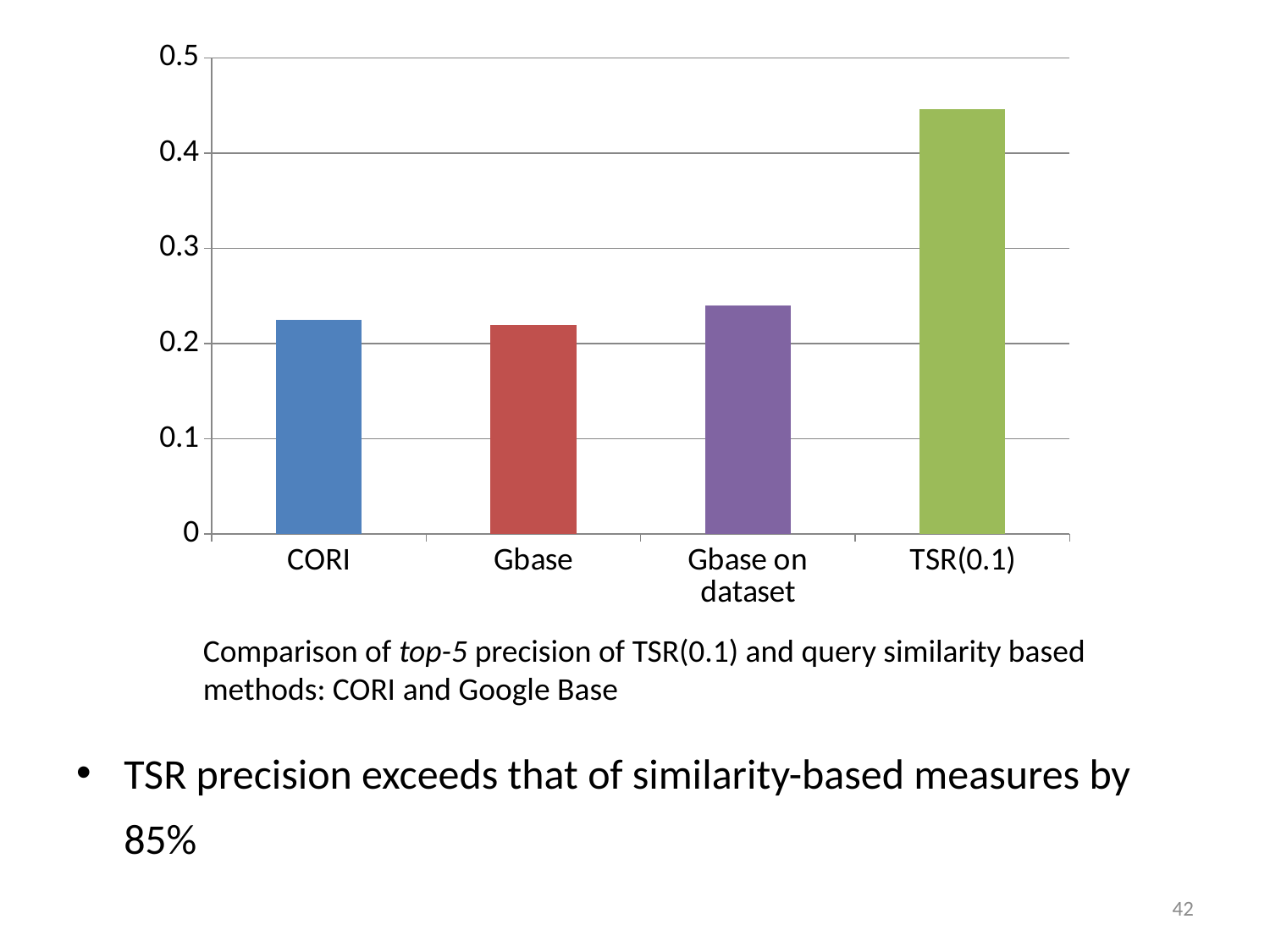
Is the value for TSR(0.1) greater or less than 0.4? greater What kind of chart is shown on the slide? bar chart Is the value for Gbase greater or less than 0.2? greater Is the value for CORI greater or less than 0.3? less Which category has the highest value in the chart? TSR(0.1) Which is larger, the value for Gbase or the value for TSR(0.1)? TSR(0.1) What colour is the bar for TSR(0.1)? green Which is larger, the value for TSR(0.1) or the value for CORI? TSR(0.1) How many categories are plotted on the x axis of the chart? 4